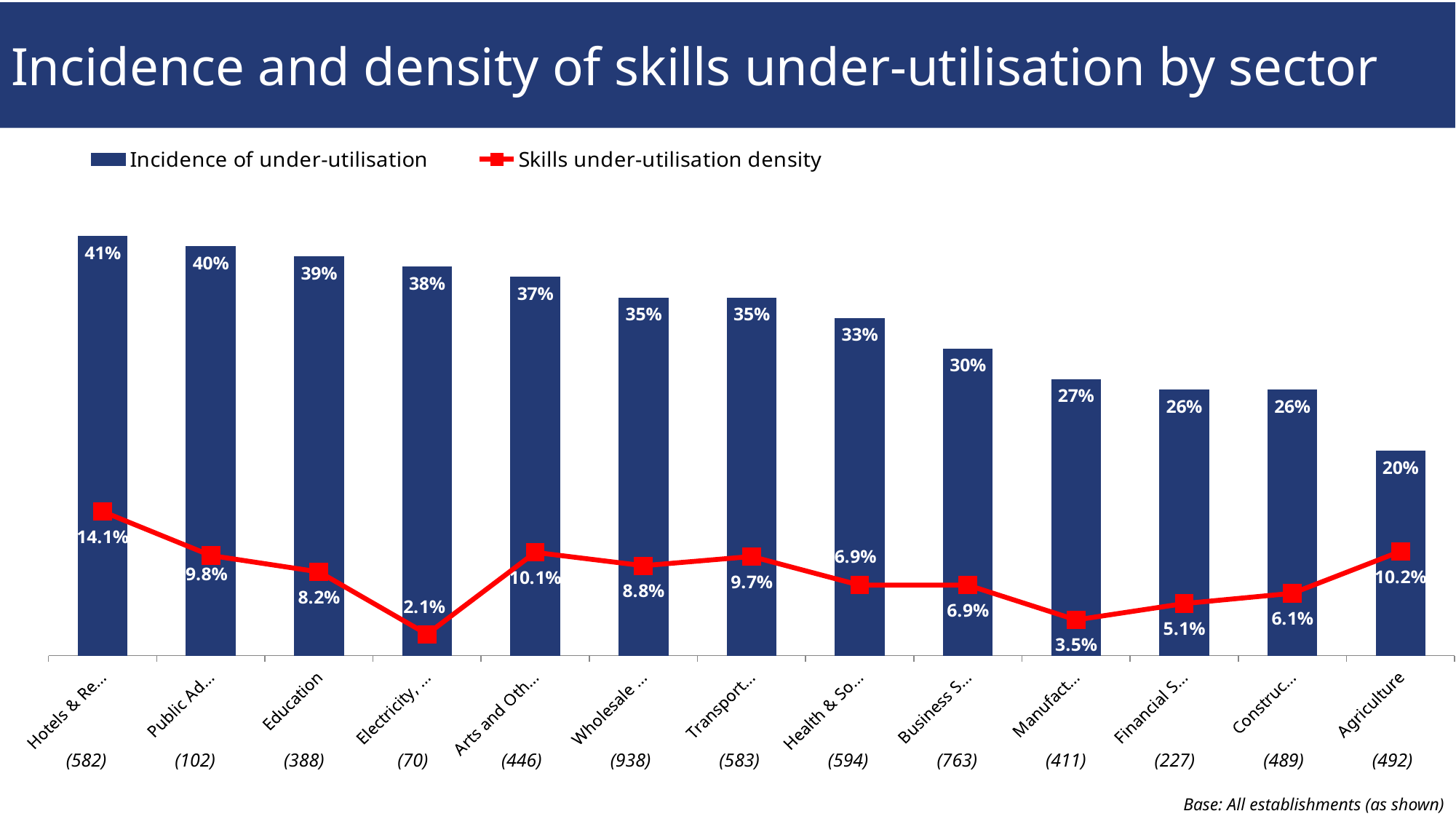
What is the incidence of under-utilisation for Education? 39% How many sectors are shown on the x axis? 13 Which has a higher incidence of under-utilisation, Education or Agriculture? Education What is the lowest value shown on the skills under-utilisation density line? 2.1% Which sector has the lowest incidence of under-utilisation? Agriculture What is the skills under-utilisation density for Agriculture? 10.2% How many series does the legend list? 2 What is the highest value shown on the skills under-utilisation density line? 14.1% What is the skills under-utilisation density for Education? 8.2% What is the incidence of under-utilisation for Agriculture? 20% What is the difference between the incidence of under-utilisation for Education and for Agriculture? 19 percentage points Do the incidence of under-utilisation bars rise or fall from left to right across the chart? fall